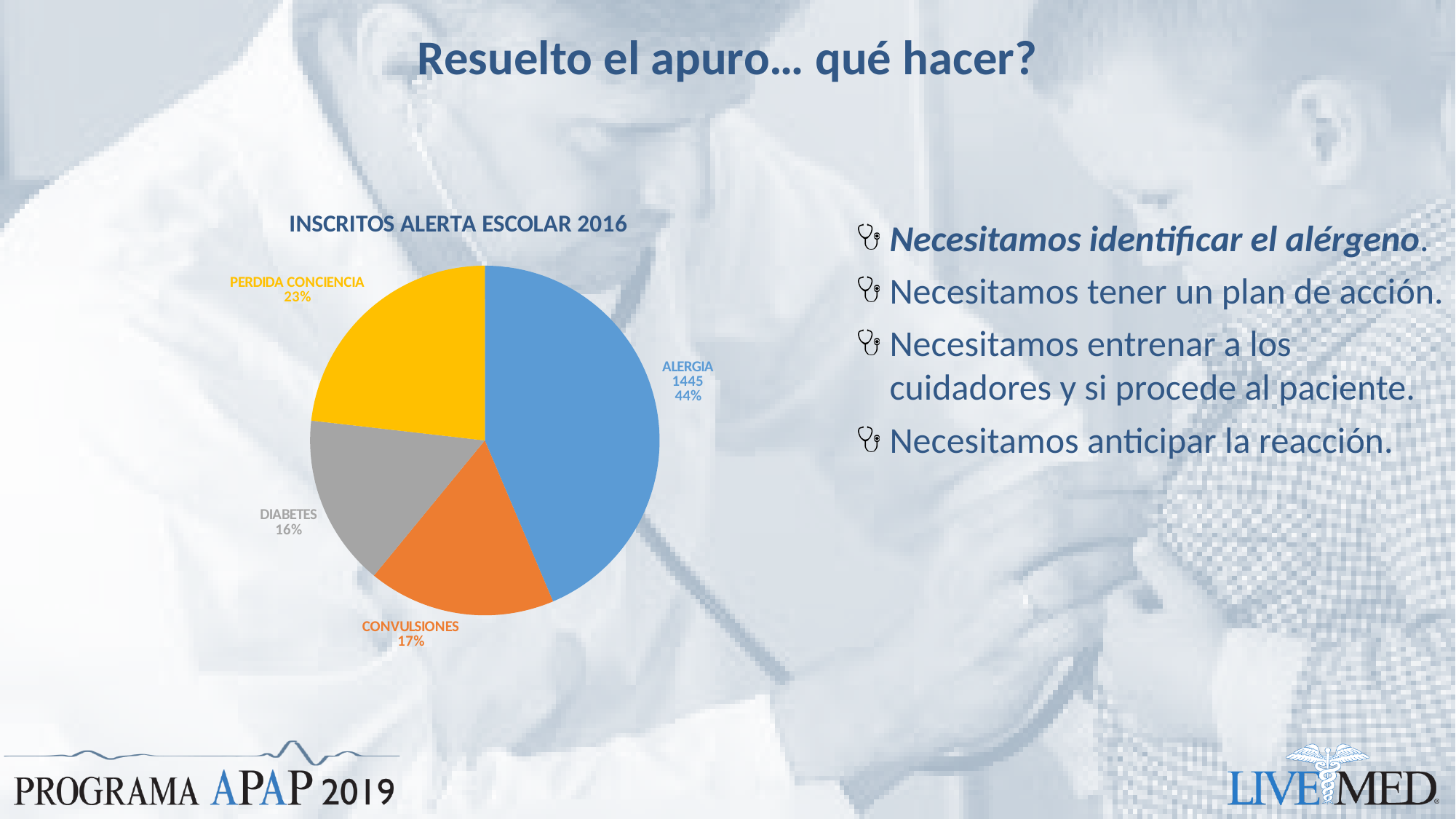
Which colour is used for the ALERGIA slice? Blue Which category has the largest share of the pie? ALERGIA What is the number of enrolled shown for ALERGIA? 1445 What is the difference in percentage points between ALERGIA and PERDIDA CONCIENCIA? 21 What percentage share does DIABETES have? 16% What is the title of the chart? INSCRITOS ALERTA ESCOLAR 2016 What percentage share does ALERGIA have in the pie chart? 44% What type of chart is shown on the slide? Pie chart Which category has the smallest share of the pie? DIABETES What percentage share does PERDIDA CONCIENCIA have? 23% How many categories does the pie chart show? 4